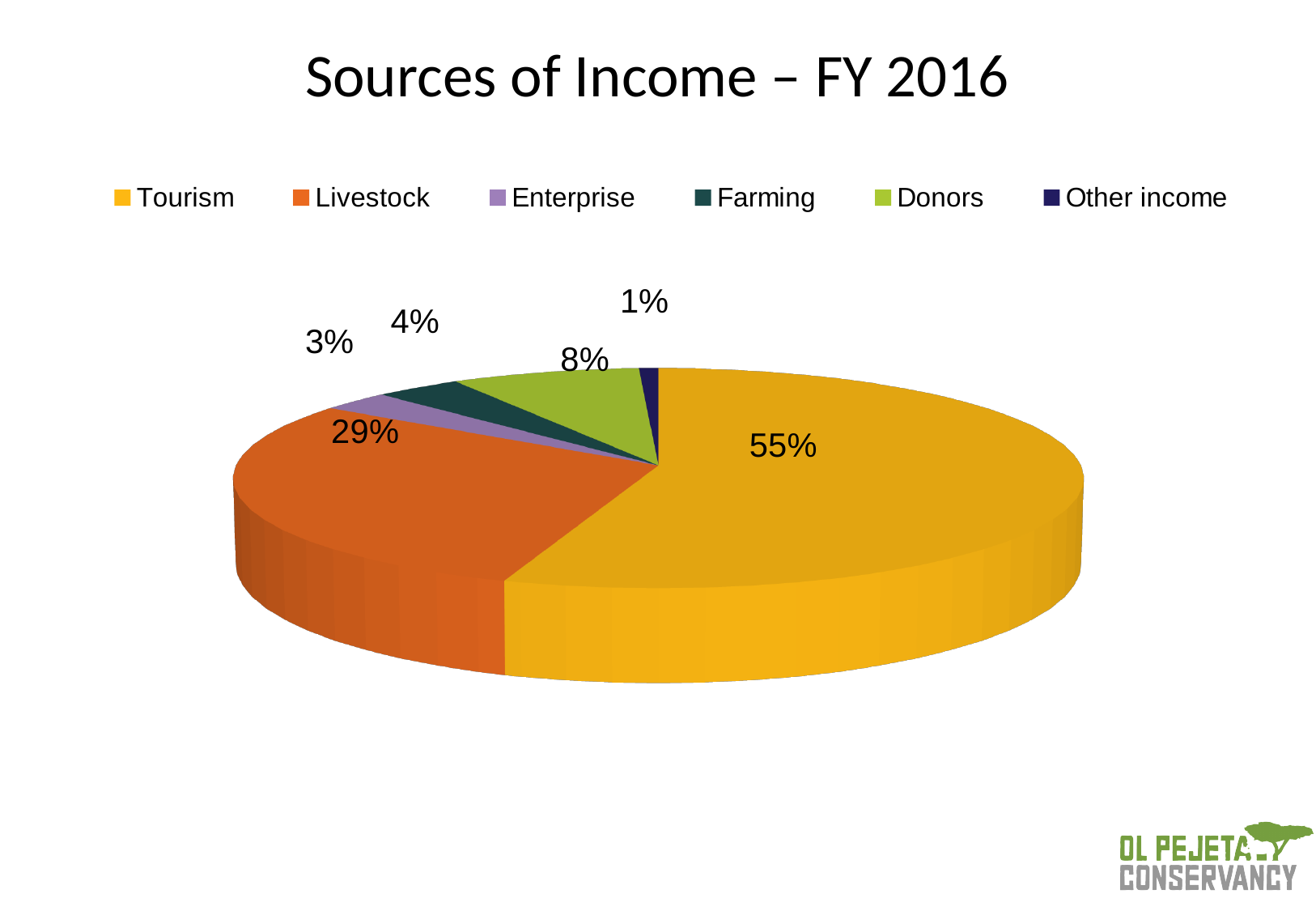
How many sources of income are shown in the pie chart? 6 What share of income comes from Donors? 8% What is the title of the chart? Sources of Income – FY 2016 What is the difference in share between Tourism and Livestock? 26% What share of income comes from Enterprise? 3% What share of income does Livestock account for? 29% What share of income comes from Farming? 4% Which source of income has the smallest share? Other income Which has a larger share, Donors or Farming? Donors What kind of chart is shown on the slide? Pie chart What share of income does Tourism account for? 55% Which source of income has the largest share? Tourism